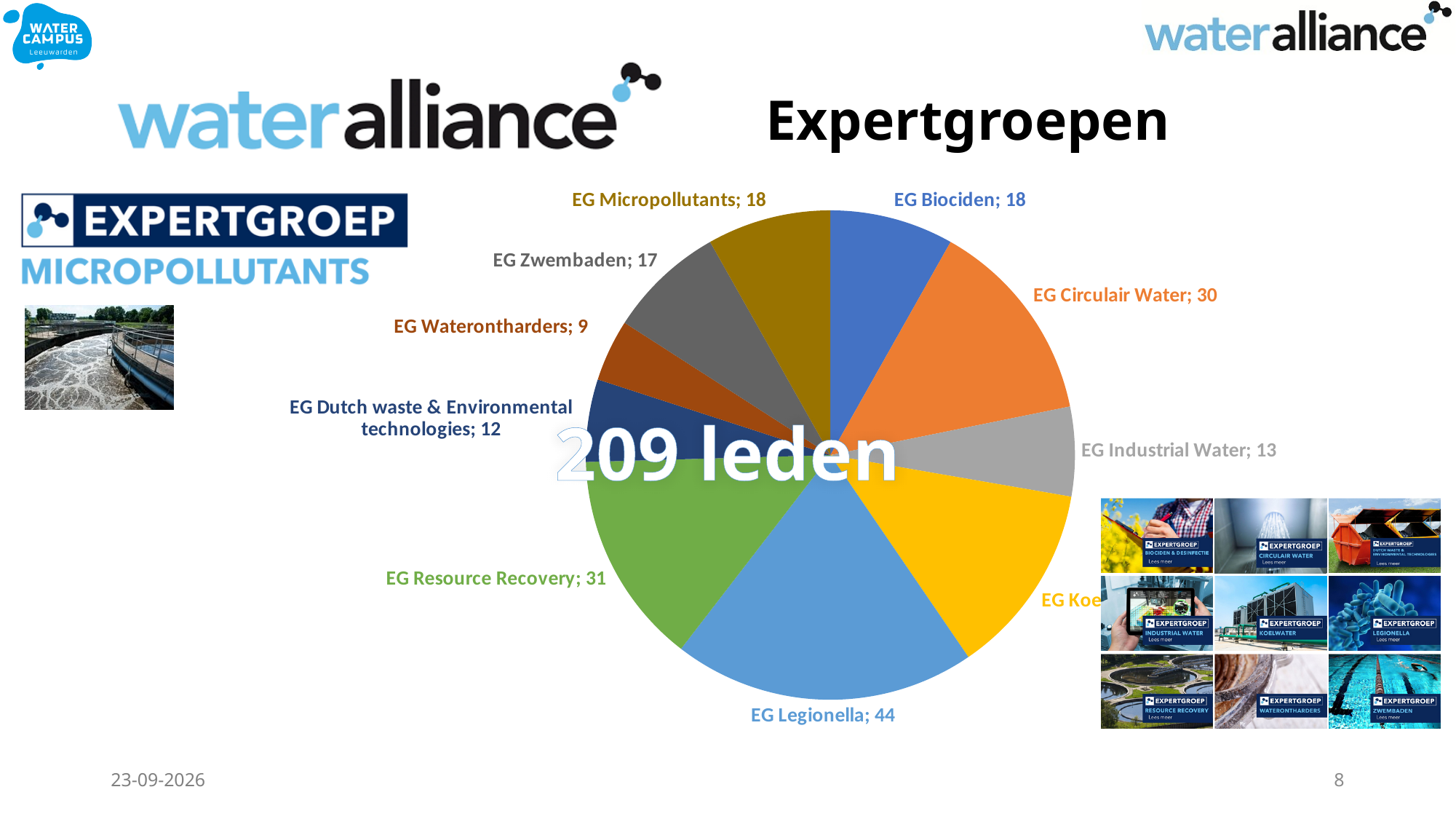
What kind of chart is shown on the slide? pie chart What is the title shown at the top of the slide next to the logo? Expertgroepen What is the difference between the values for EG Legionella and EG Resource Recovery? 13 What text is displayed in the centre of the pie chart? 209 leden How many slices does the pie chart have? 10 What is the value shown for EG Dutch waste & Environmental technologies? 12 How many members does EG Legionella have according to the pie chart? 44 Which has a larger value, EG Resource Recovery or EG Circulair Water? EG Resource Recovery What is the value shown for EG Waterontharders? 9 What is the value shown for EG Circulair Water? 30 Which expert group has the smallest slice of the pie chart? EG Waterontharders Which expert group has the largest slice of the pie chart? EG Legionella